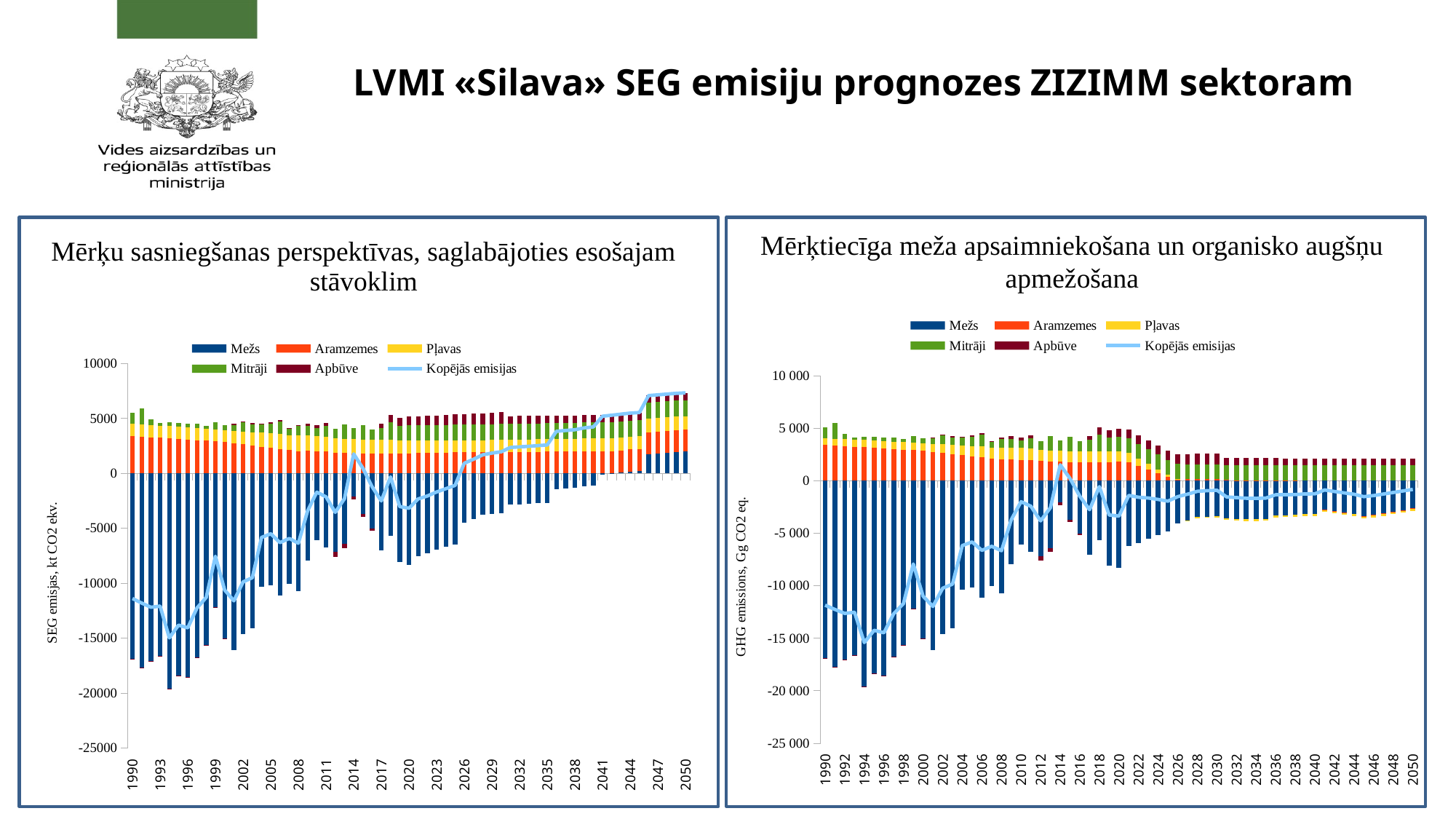
In the left chart, does the Kopējās emisijas line overall rise or fall from 1990 to 2050? rise What is the y-axis label of the right chart? GHG emissions, Gg CO2 eq. In the left chart, is the Mežs value in 1994 greater or less than -15000? less In the right chart, is the Mežs value in 1994 greater or less than -15 000? less What is the y-axis label of the left chart? SEG emisijas, kt CO2 ekv. How many series does the legend of the left chart list? 6 What type of chart is the left chart titled "Mērķu sasniegšanas perspektīvas, saglabājoties esošajam stāvoklim"? Stacked bar chart with a line In the right chart, is the value of the Kopējās emisijas line in 2050 greater or less than 0? less In the left chart, which year has the lowest Mežs value? 1994 How many series does the legend of the right chart list? 6 In the left chart, is the Kopējās emisijas value larger in 1990 or in 2050? 2050